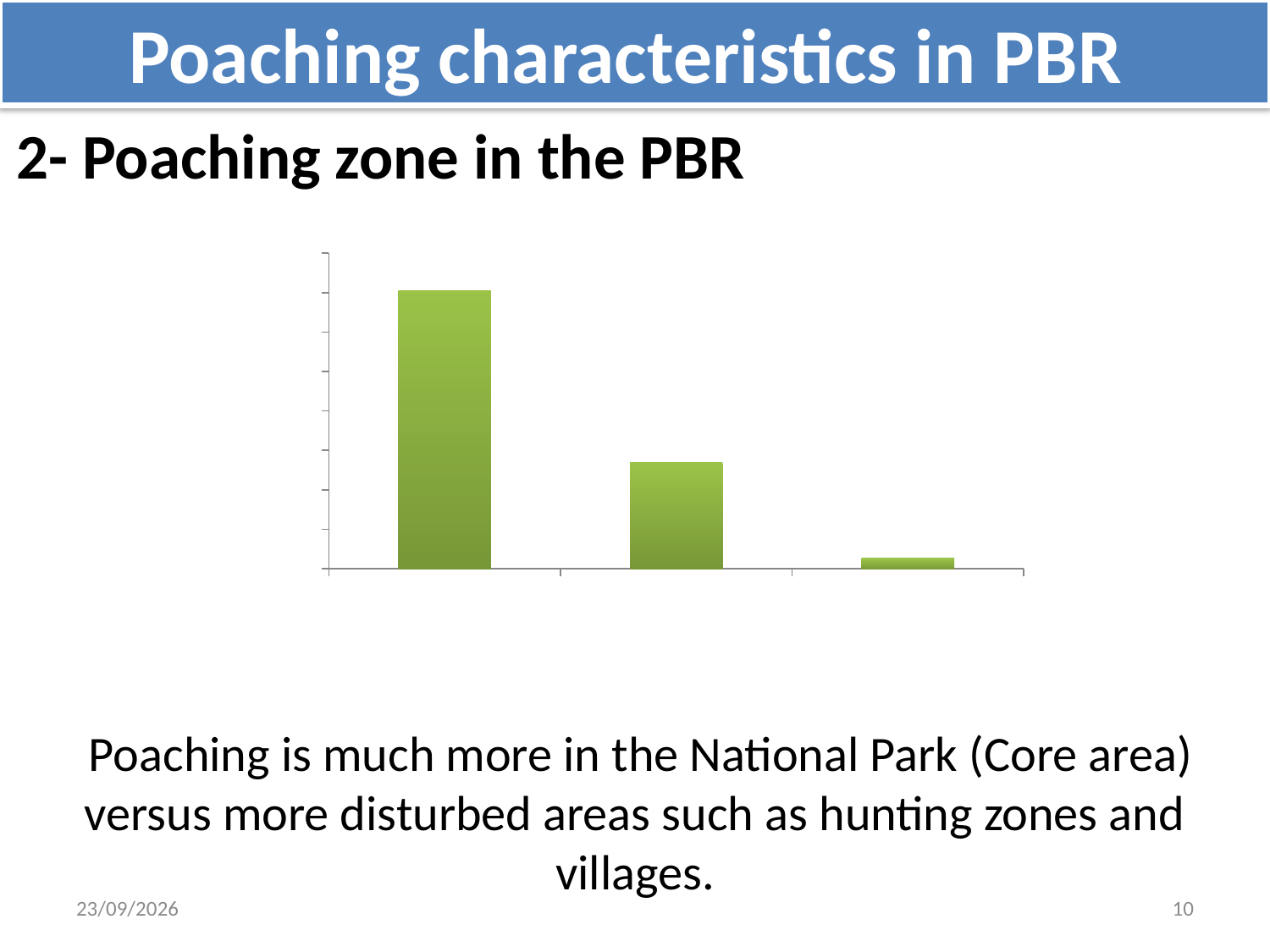
Is the rightmost bar taller or shorter than the middle bar? shorter What kind of chart is shown on the slide? bar chart What colour are the bars in the chart? green Do the bar heights rise or fall from left to right across the chart? fall Which bar in the chart is the shortest: the leftmost, the middle, or the rightmost? the rightmost Is the leftmost bar taller or shorter than the middle bar? taller Which bar in the chart is the tallest: the leftmost, the middle, or the rightmost? the leftmost Does the chart display a legend? No How many bars does the chart show? 3